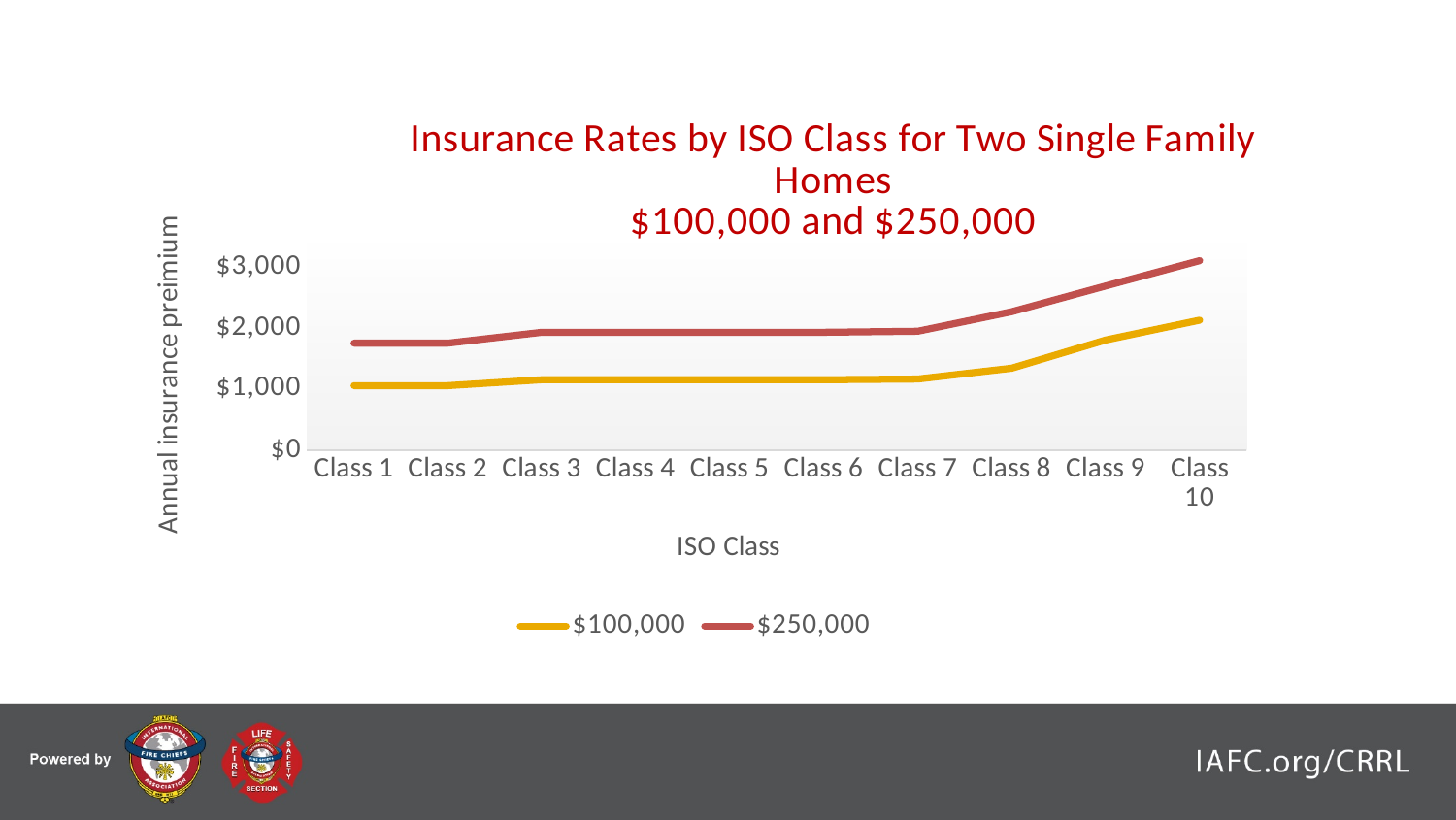
How many ISO classes are plotted along the x axis? 10 What kind of chart is shown on the slide? Line chart Is the annual insurance premium for the $250,000 home at Class 8 greater or less than $2,000? greater Do the annual insurance premiums rise or fall as the ISO class goes from Class 1 to Class 10? Rise What is the title of the chart? Insurance Rates by ISO Class for Two Single Family Homes $100,000 and $250,000 Which ISO class has the highest annual insurance premium for the $250,000 home? Class 10 Which ISO class has the highest annual insurance premium for the $100,000 home? Class 10 How many series does the legend list? 2 What is the label of the y axis? Annual insurance premium At Class 10, which series has the larger annual insurance premium, $100,000 or $250,000? $250,000 Is the annual insurance premium for the $250,000 home at Class 1 greater or less than $2,000? less Is the annual insurance premium for the $100,000 home at Class 8 greater or less than $1,000? greater